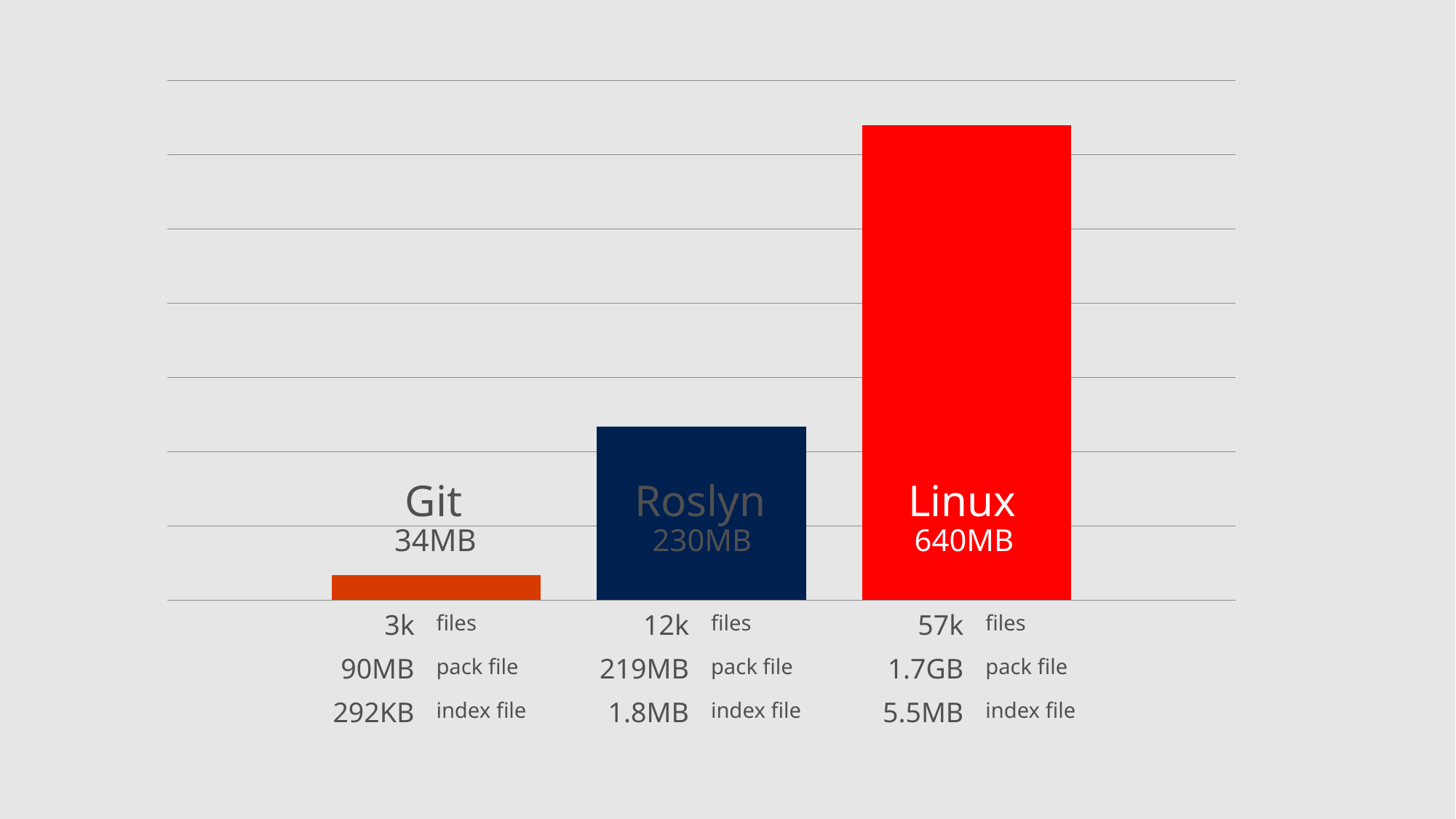
What is the difference between the Linux value and the Git value? 606MB How many bars are in the chart? 3 Do the bar values rise or fall from left to right? Rise Which category has the lowest bar? Git What is the value shown for Git? 34MB What is the difference between the Linux value and the Roslyn value? 410MB What kind of chart is shown on the slide? Bar chart What colour is the Linux bar? Red What is the value shown for Linux? 640MB Which is larger, the value for Roslyn or the value for Git? Roslyn Which category has the highest bar? Linux What is the value shown for Roslyn? 230MB